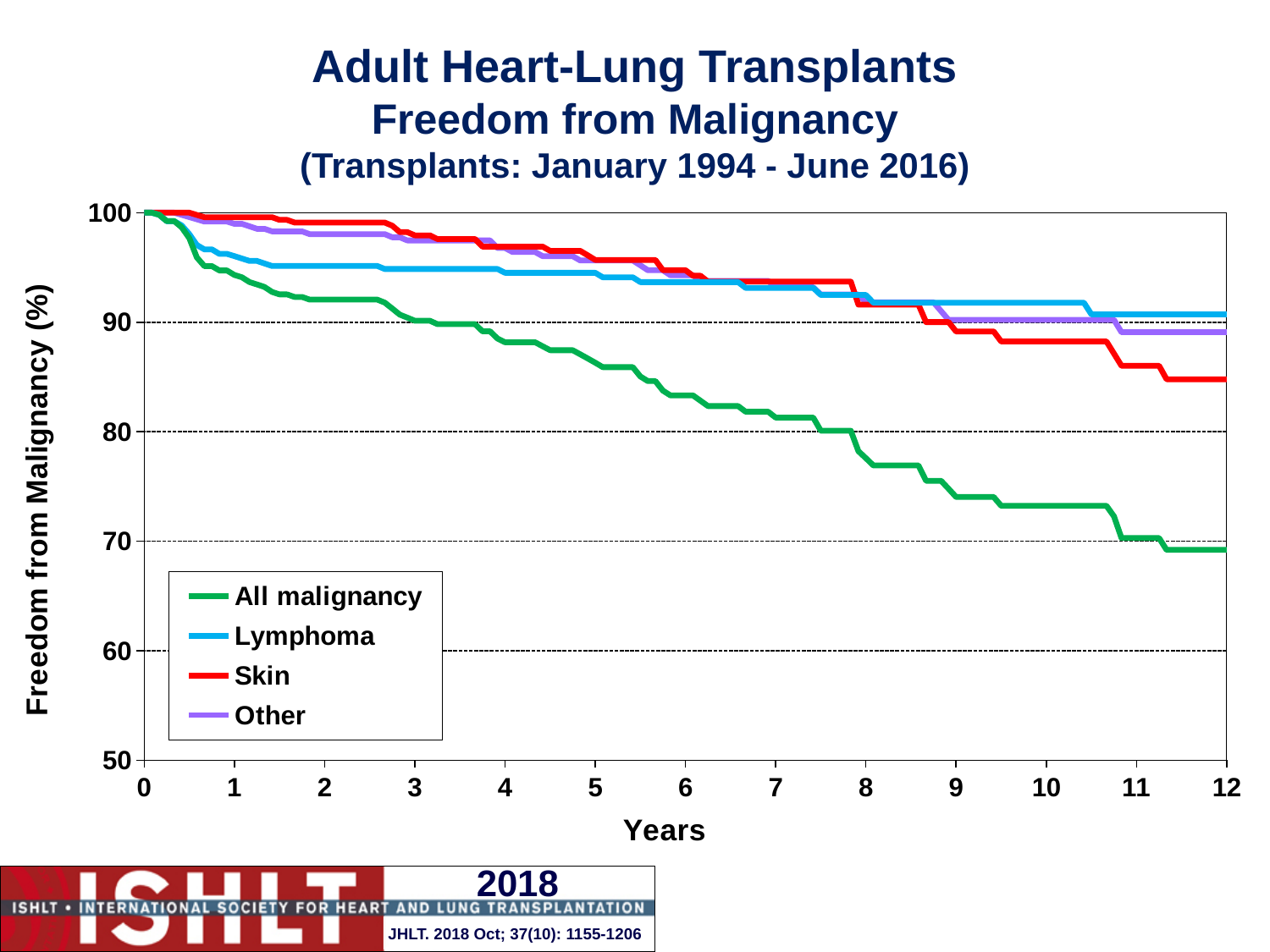
Does the All malignancy series rise or fall as the years increase? fall Which series has the lowest value at year 12? All malignancy What are the series listed in the legend? All malignancy, Lymphoma, Skin, Other What is the value of the All malignancy series at year 0? 100 What is the label of the y axis? Freedom from Malignancy (%) Is the value for Lymphoma at year 6 greater or less than 90? greater How many series does the legend list? 4 Is the value for All malignancy at year 10 greater or less than 80? less At year 3, which is higher: All malignancy or Skin? Skin At year 12, which is higher: Lymphoma or Skin? Lymphoma What kind of chart is shown on the slide? line chart Is the value for Skin at year 12 greater or less than 90? less